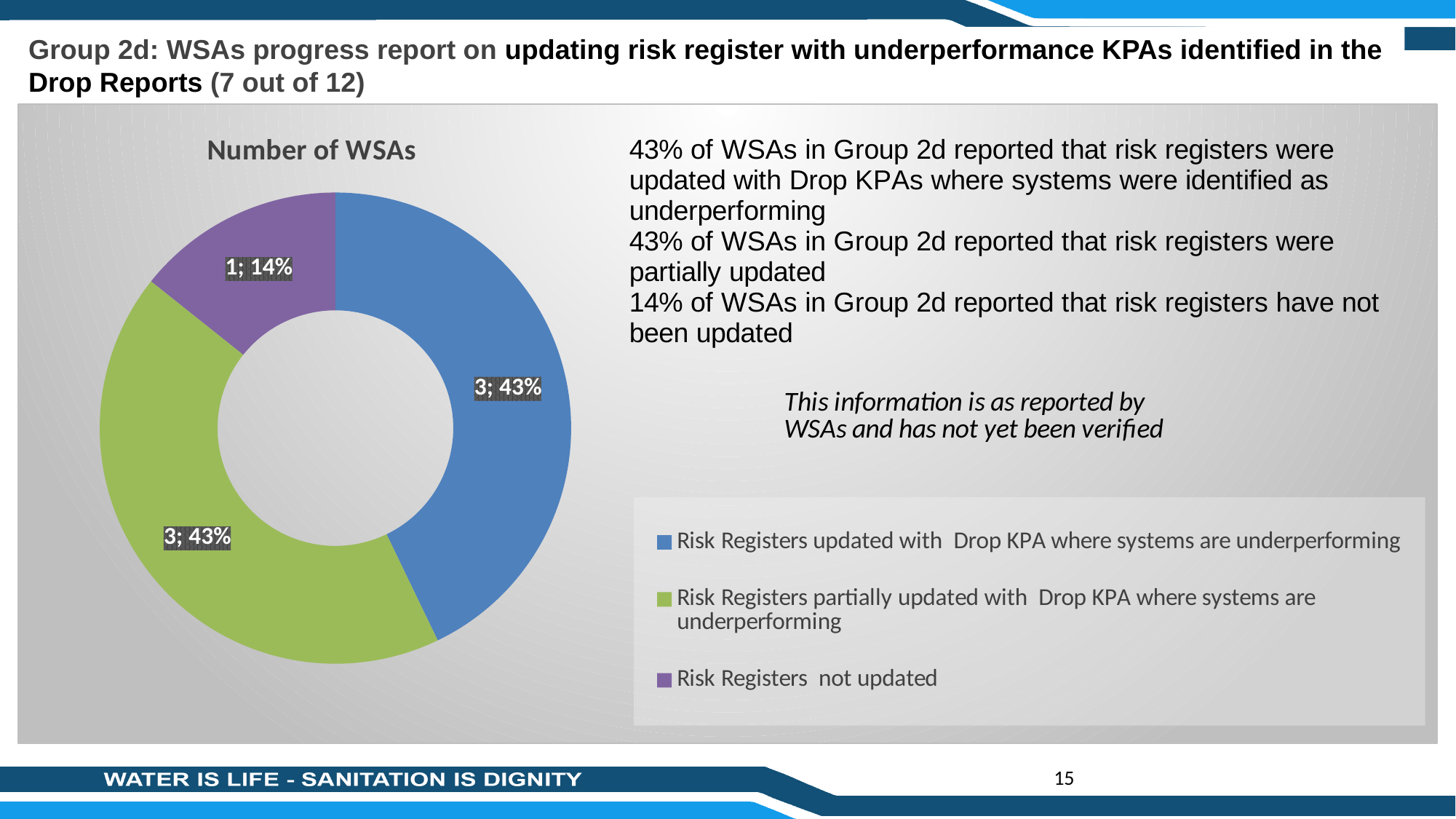
What share of the chart is taken by 'Risk Registers not updated'? 14% Which is larger: the number of WSAs with risk registers updated with Drop KPA, or the number with risk registers not updated? Risk Registers updated with Drop KPA where systems are underperforming What share of the chart is taken by 'Risk Registers partially updated with Drop KPA where systems are underperforming'? 43% What is the title of the chart? Number of WSAs What is the total number of WSAs across all slices of the chart? 7 How many WSAs reported that risk registers were updated with Drop KPA where systems are underperforming? 3 What is the difference between the number of WSAs with risk registers partially updated and the number with risk registers not updated? 2 What kind of chart is shown on the slide? doughnut chart How many WSAs reported that risk registers were not updated? 1 How many categories does the chart show? 3 How many WSAs reported that risk registers were partially updated with Drop KPA where systems are underperforming? 3 Which category has the smallest slice in the chart? Risk Registers not updated